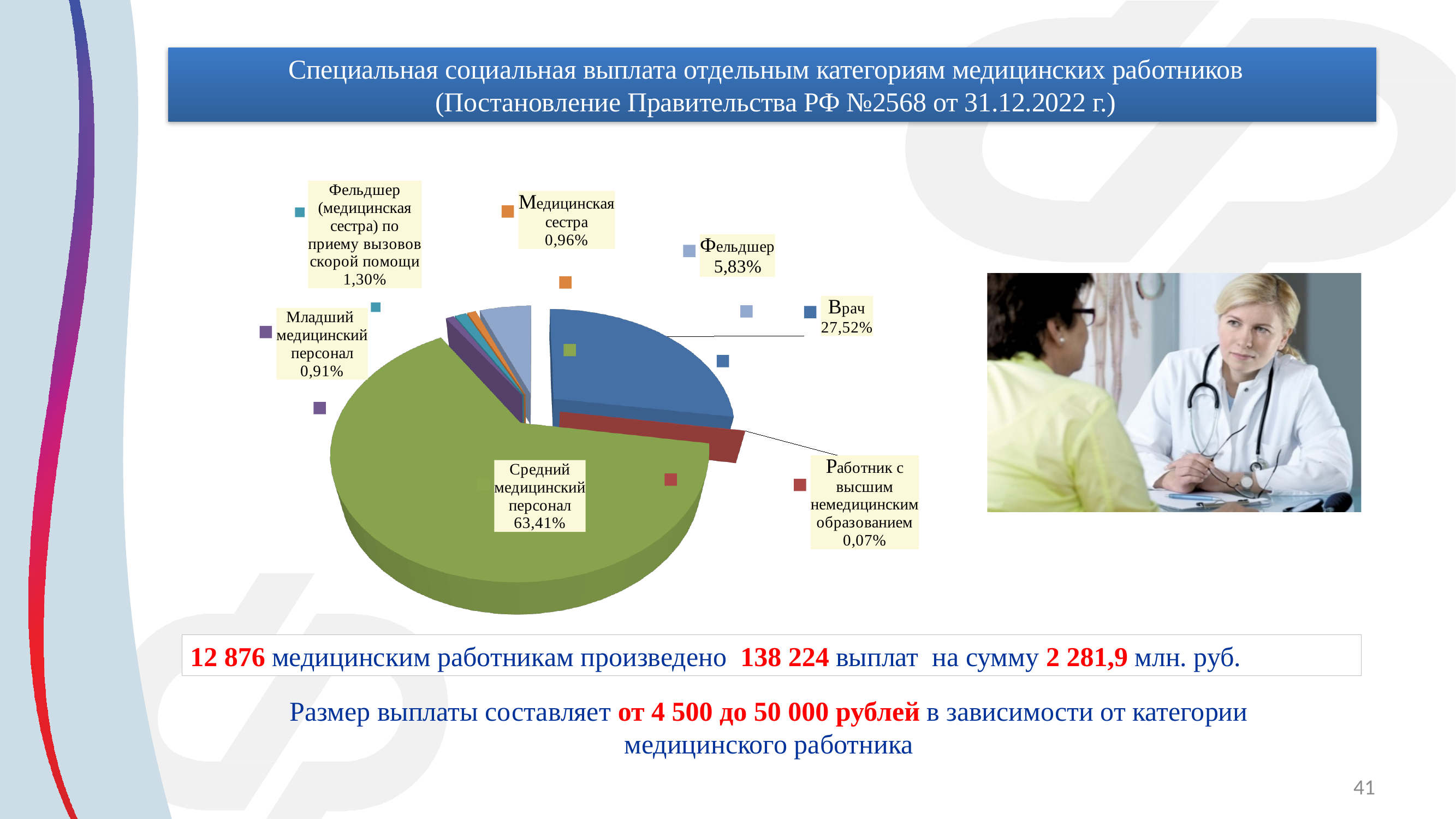
What share of the pie chart does "Младший медицинский персонал" have? 0,91% What share of the pie chart does "Врач" have? 27,52% What is the difference in percentage points between "Средний медицинский персонал" and "Врач"? 35,89 Which category has the smallest slice of the pie chart? Работник с высшим немедицинским образованием Which is larger in the pie chart: "Фельдшер" or "Медицинская сестра"? Фельдшер How many categories are shown in the pie chart? 7 What colour is the slice for "Средний медицинский персонал" in the pie chart? Green What share of the pie chart does "Работник с высшим немедицинским образованием" have? 0,07% What kind of chart is shown on the slide? Pie chart Which category has the largest slice of the pie chart? Средний медицинский персонал What share of the pie chart does "Средний медицинский персонал" have? 63,41% What share of the pie chart does "Фельдшер" have? 5,83%